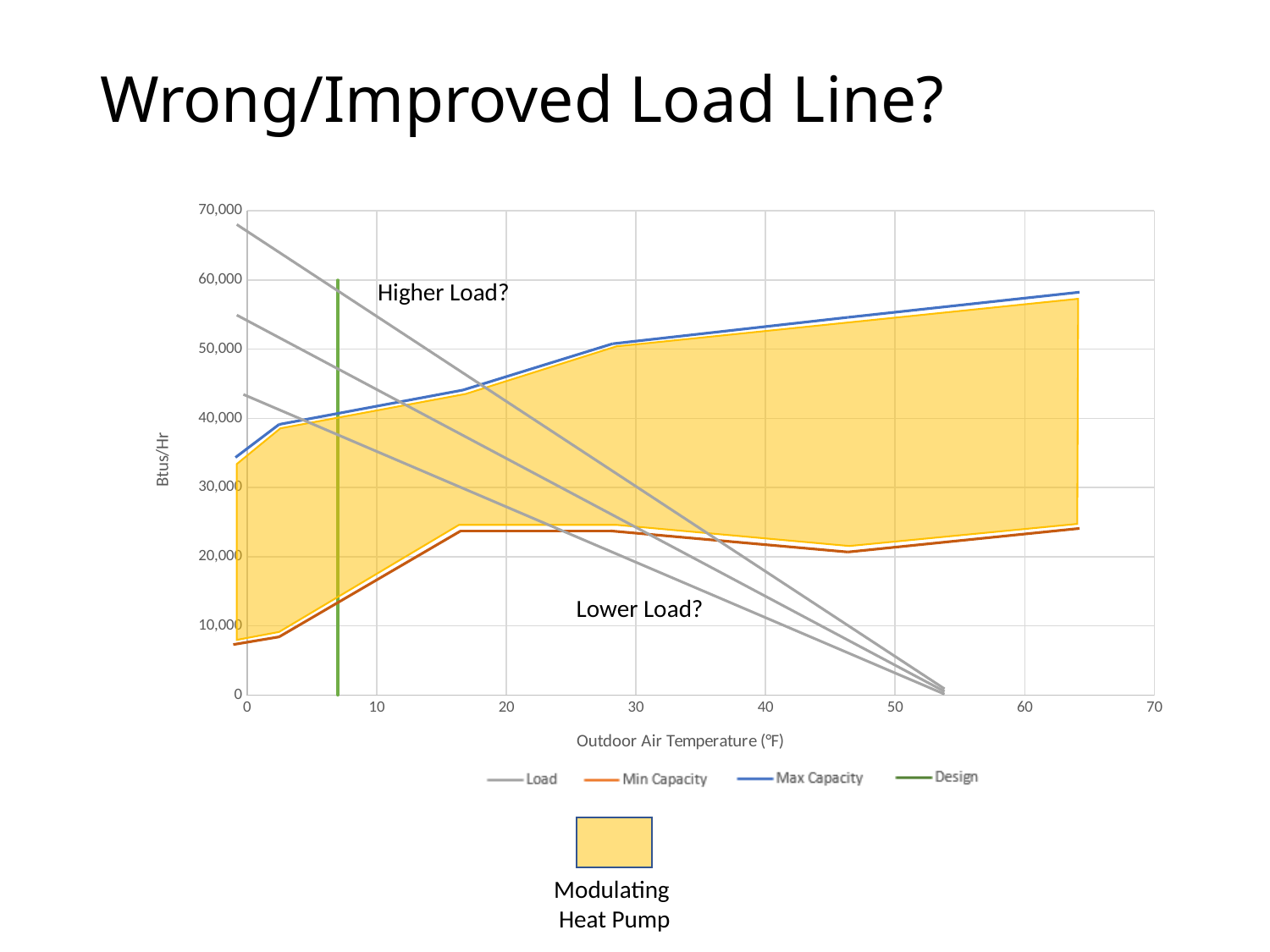
Does the Max Capacity line rise or fall as outdoor air temperature increases? rise How many gray Load lines are drawn on the chart? 3 What is the title of the slide containing the chart? Wrong/Improved Load Line? At 30°F, which is larger: Max Capacity or Min Capacity? Max Capacity How many series does the chart legend list? 4 What kind of chart is shown on the slide? line chart Is the Max Capacity value at 60°F greater or less than 50,000? greater Is the Min Capacity value at 0°F greater or less than 10,000? less Do the gray Load lines rise or fall as outdoor air temperature increases? fall What is the label of the chart's x axis? Outdoor Air Temperature (°F) Is the Max Capacity value at 0°F greater or less than 40,000? less